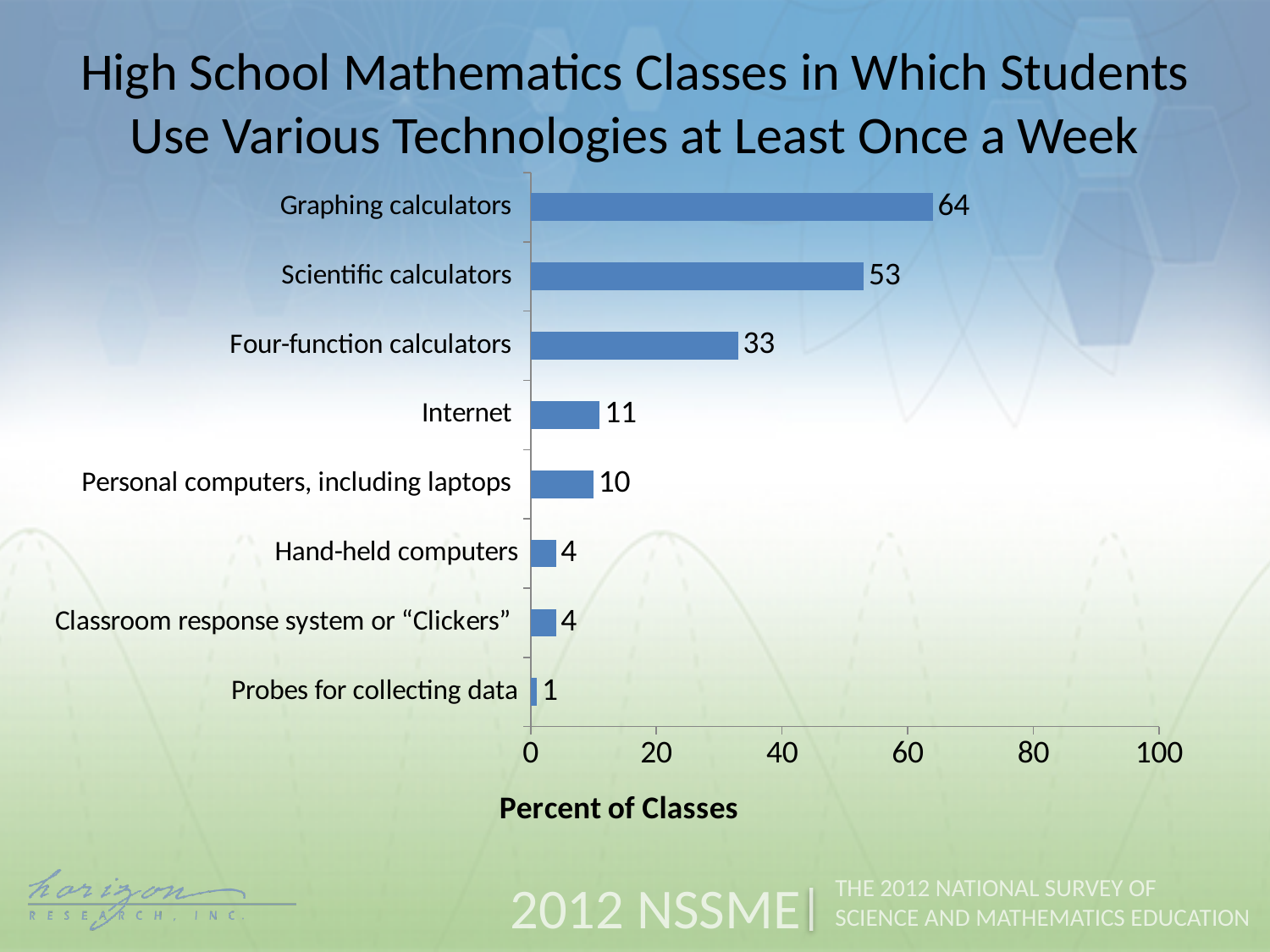
What kind of chart is shown on the slide? Bar chart What is the difference between the values for Graphing calculators and Scientific calculators? 11 What percent of classes use graphing calculators at least once a week? 64 What is the value for Internet? 11 What is the label of the horizontal axis? Percent of Classes Is the value for Scientific calculators greater or less than 40? greater Which technology has the lowest percent of classes? Probes for collecting data How many technology categories are shown in the chart? 8 What is the difference between the values for Scientific calculators and Four-function calculators? 20 Which is larger, the value for Four-function calculators or the value for Internet? Four-function calculators Which technology has the highest percent of classes? Graphing calculators What is the value for Personal computers, including laptops? 10